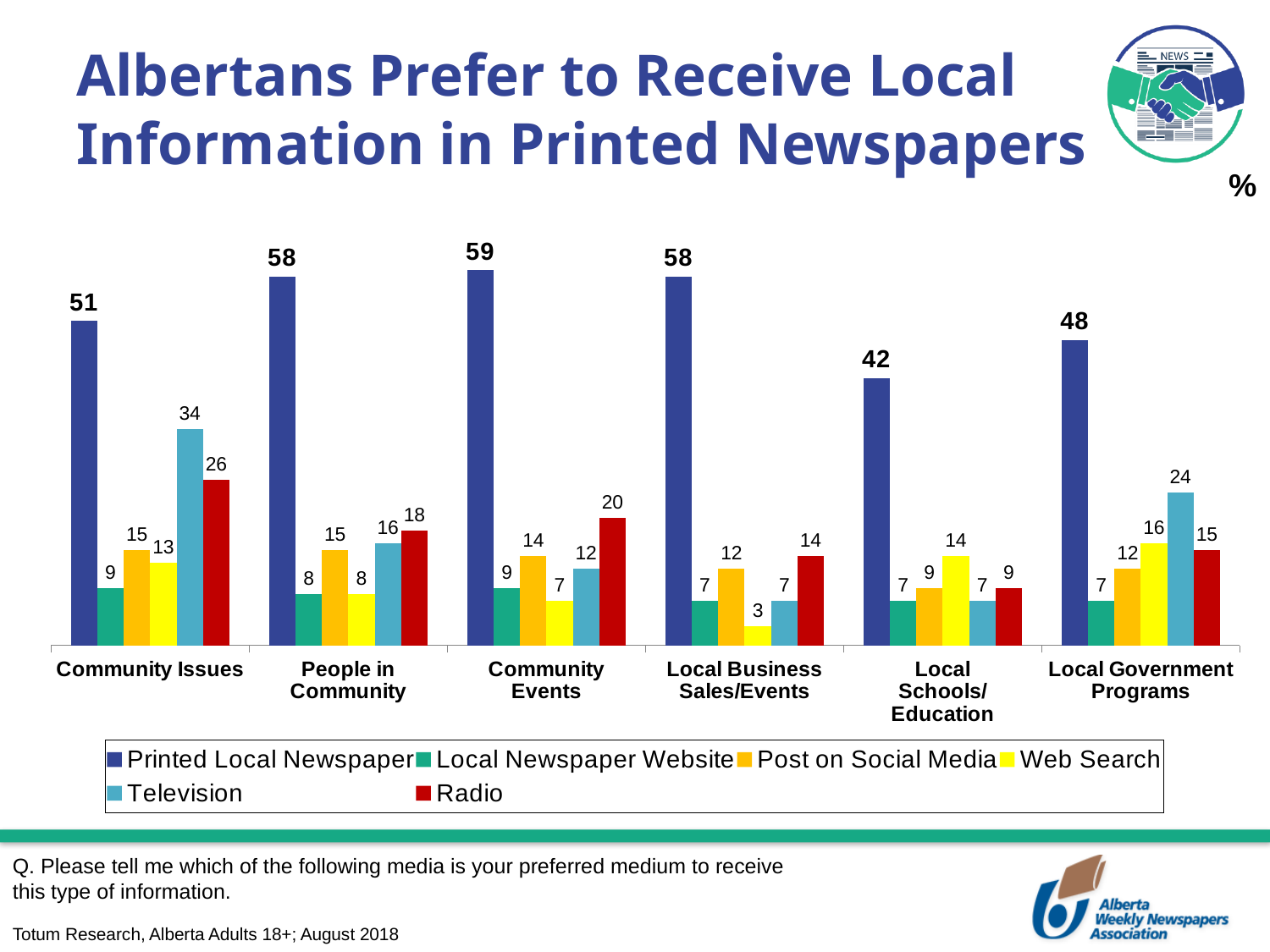
In which category is the Printed Local Newspaper value highest? Community Events Which is larger in the Local Schools/Education category: Web Search or Post on Social Media? Web Search What is the value for Television in the Local Government Programs category? 24 What is the value for Web Search in the Local Business Sales/Events category? 3 How many series does the legend list? 6 What is the value for Printed Local Newspaper in the Community Issues category? 51 In which category is the Printed Local Newspaper value lowest? Local Schools/Education What kind of chart is shown on the slide? Bar chart What is the difference between the Television value and the Radio value in the Community Issues category? 8 What is the value for Radio in the Community Events category? 20 Which series is shown in red in the legend? Radio How many categories are shown on the x axis? 6